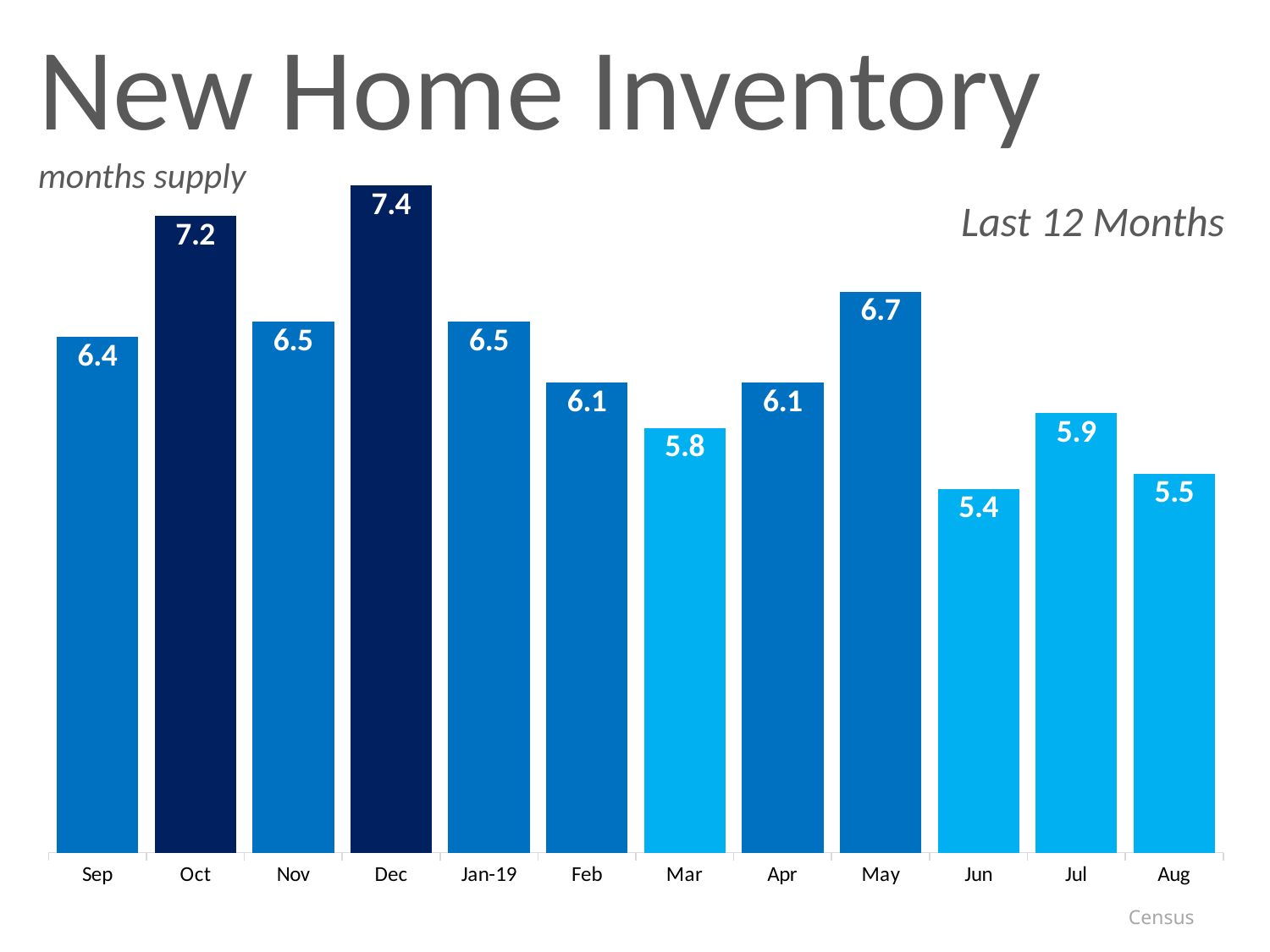
What kind of chart is shown on the slide? Bar chart Which is larger, the value for May or the value for Jul? May What is the months supply of new home inventory for Dec? 7.4 Do the values rise or fall from May to Jun? Fall What is the title of the chart? New Home Inventory What is the difference between the Oct value and the Sep value? 0.8 What is the difference between the Dec value and the Jun value? 2.0 What is the value for Jan-19? 6.5 How many months are shown on the x axis? 12 Which month has the lowest months supply? Jun Which month has the highest months supply? Dec What is the months supply value shown for Jun? 5.4